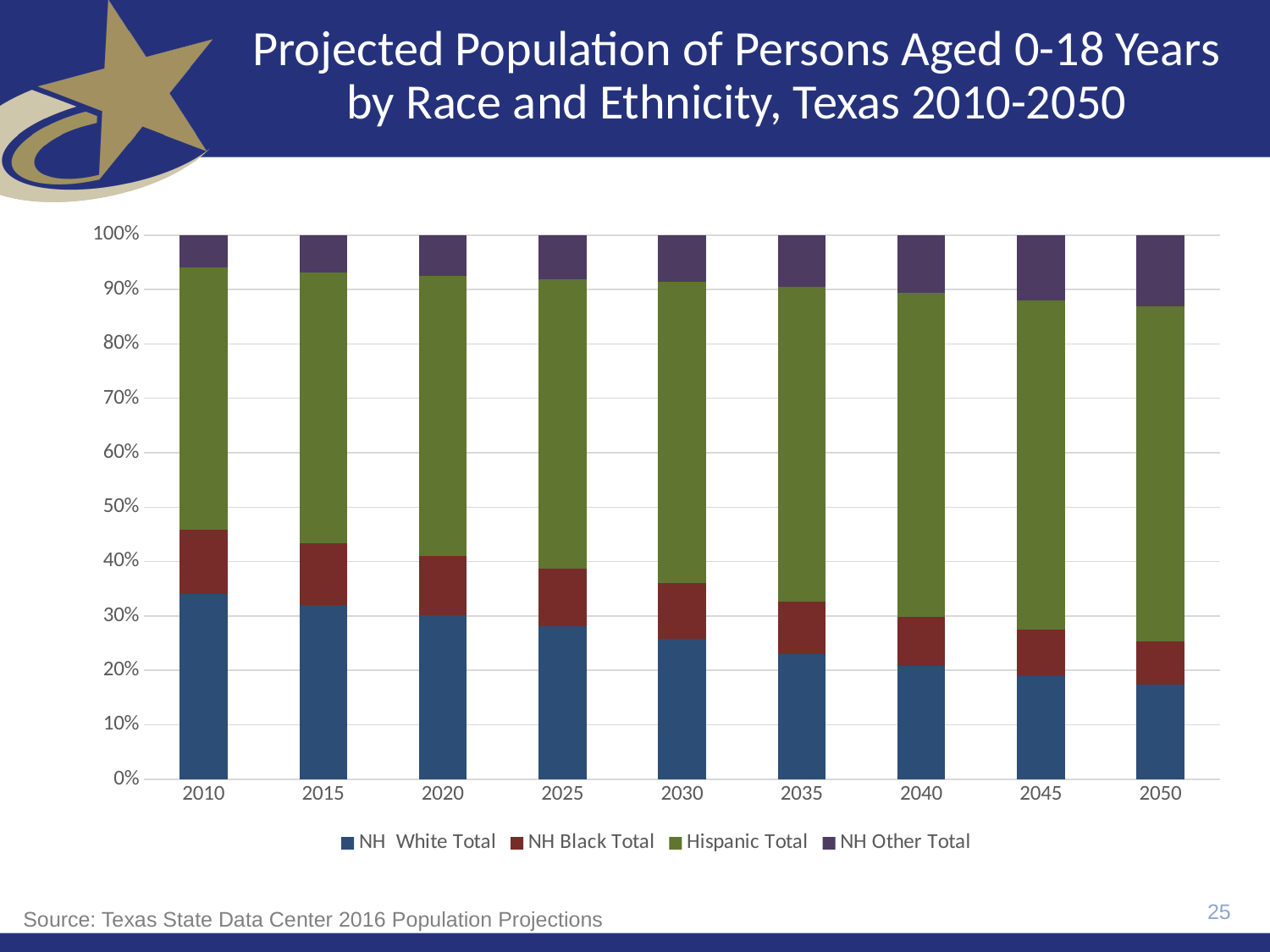
What kind of chart is shown on the slide? Stacked bar chart What is the title of the chart on the slide? Projected Population of Persons Aged 0-18 Years by Race and Ethnicity, Texas 2010-2050 Is the value for NH Other Total in 2010 greater or less than 10%? less How many years are shown along the x axis of the chart? 9 Is the value for NH White Total in 2050 greater or less than 20%? less Is the value for NH White Total in 2010 greater or less than 30%? greater How many series does the chart legend list? 4 In 2050, which is larger, the Hispanic Total share or the NH White Total share? Hispanic Total Does the share of NH White Total rise or fall from 2010 to 2050? Fall In which year is the NH White Total share the highest? 2010 Does the share of Hispanic Total rise or fall from 2010 to 2050? Rise Which series is listed first in the chart legend? NH White Total